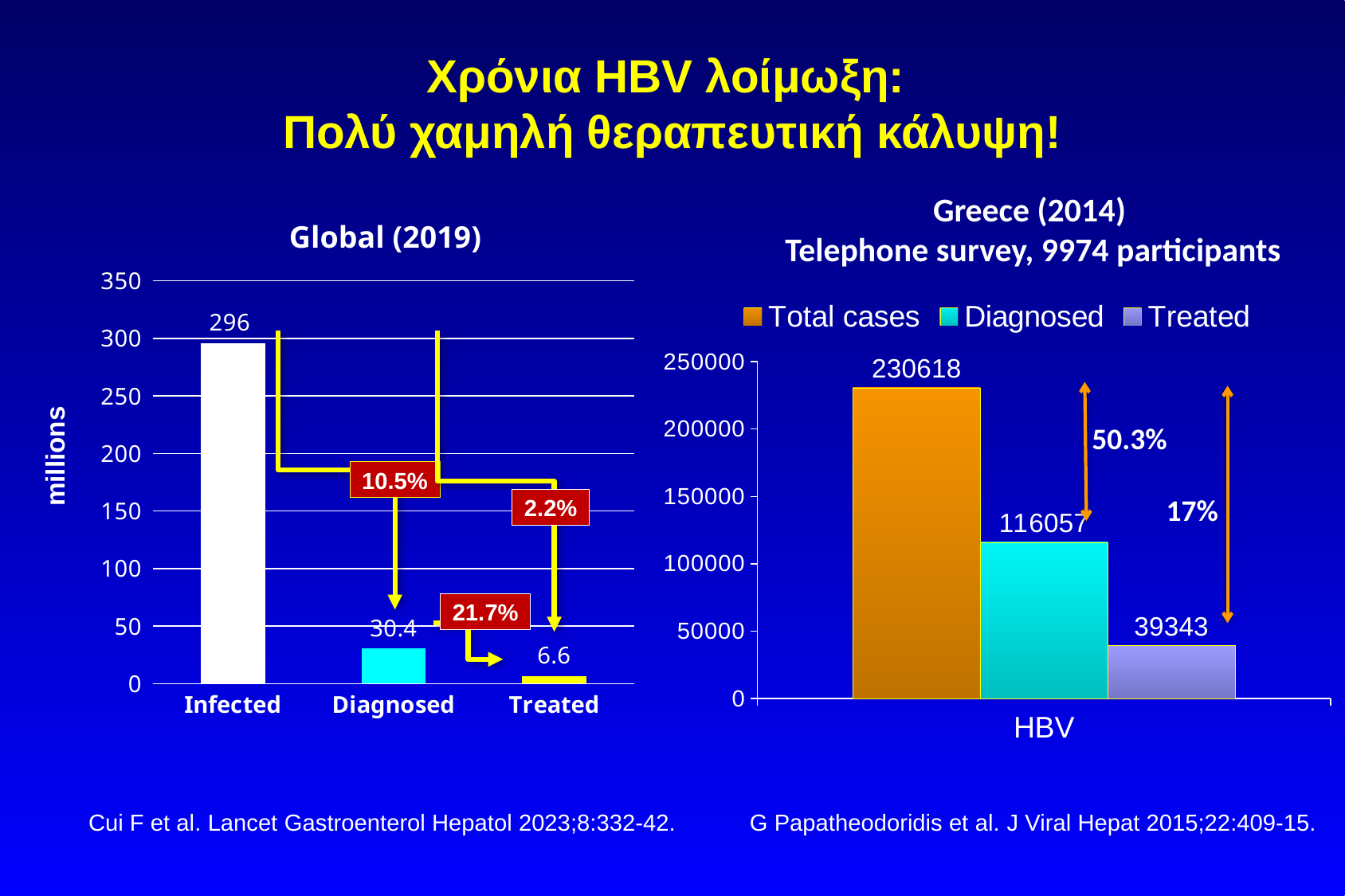
In the Global (2019) chart, what is the value for Treated? 6.6 In the Global (2019) chart, which category has the lowest value? Treated In the Greece (2014) chart, how many series does the legend list? 3 In the Global (2019) chart, what is the value for Infected? 296 In the Greece (2014) chart, what is the value for Treated? 39343 In the Global (2019) chart, what is the value for Diagnosed? 30.4 In the Global (2019) chart, what is the y-axis label? millions In the Greece (2014) chart, what is the difference between Diagnosed and Treated? 76714 In the Global (2019) chart, what is the difference between the Infected and Diagnosed values? 265.6 In the Greece (2014) chart, what is the value for Diagnosed? 116057 In the Global (2019) chart, how many categories are shown on the x axis? 3 In the Greece (2014) chart, what is the value for Total cases? 230618